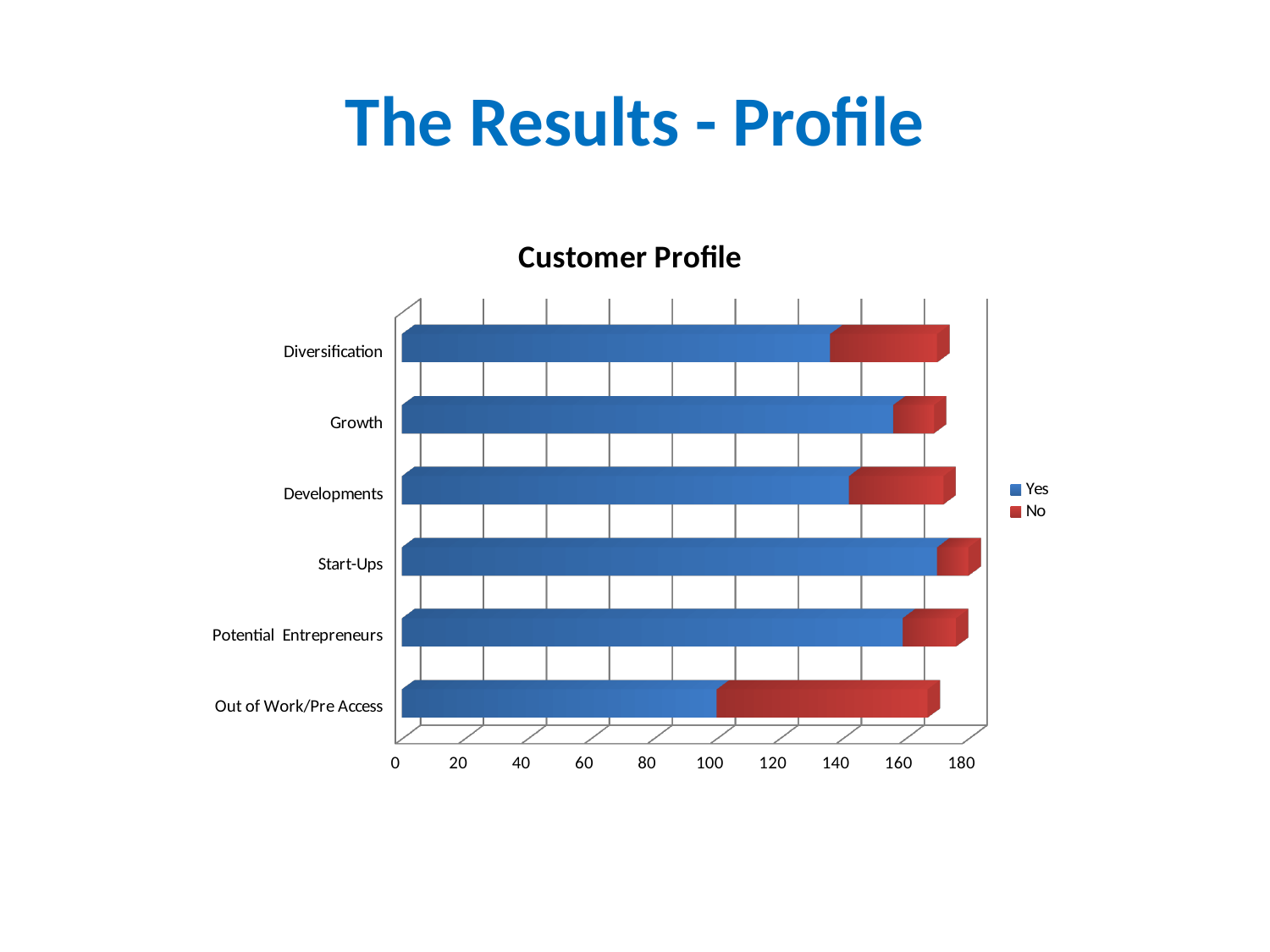
What kind of chart is shown on the slide? bar chart Which colour represents the Yes series in the legend? blue Which category has the largest No value? Out of Work/Pre Access Is the Yes value for Start-Ups greater or less than 160? greater Which has the larger Yes value, Growth or Diversification? Growth How many categories are shown on the chart? 6 Which category has the lowest Yes value? Out of Work/Pre Access Which category has the highest Yes value? Start-Ups How many series does the legend list? 2 Is the Yes value for Diversification greater or less than 120? greater Is the Yes value for Out of Work/Pre Access greater or less than 120? less What is the title of the chart? Customer Profile